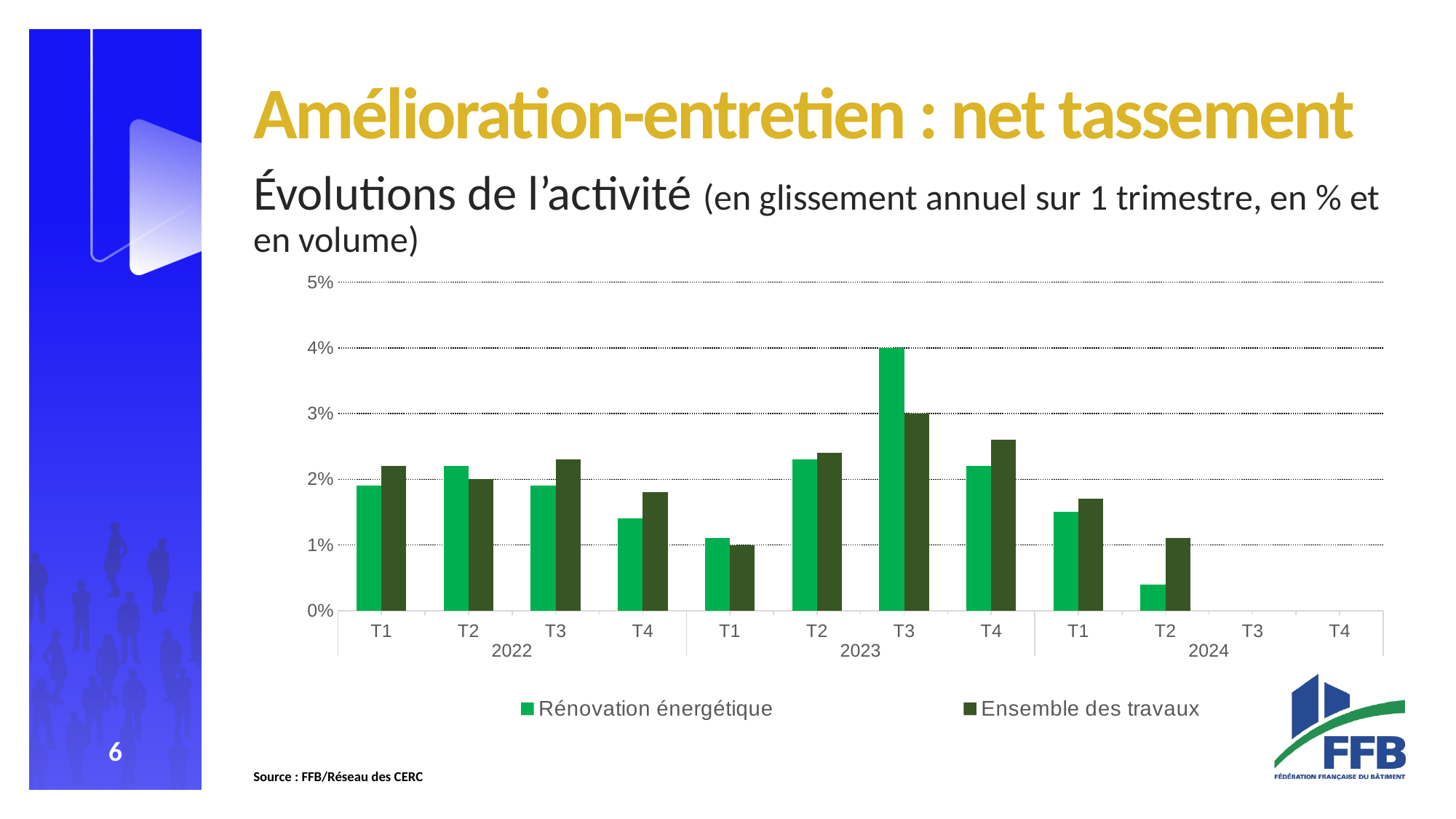
In which quarter is the value for Rénovation énergétique highest? T3 2023 What is the value for Ensemble des travaux in T3 2023? 3% What are the two series named in the legend? Rénovation énergétique and Ensemble des travaux In T1 2022, which series has the larger value, Rénovation énergétique or Ensemble des travaux? Ensemble des travaux What is the value for Rénovation énergétique in T3 2023? 4% In which quarter is the value for Ensemble des travaux highest? T3 2023 Do the values for Rénovation énergétique rise or fall from T3 2023 to T2 2024? fall In T2 2022, which series has the larger value, Rénovation énergétique or Ensemble des travaux? Rénovation énergétique Is the value for Rénovation énergétique in T2 2024 greater or less than 1%? less Among the quarters with bars plotted, in which quarter is the value for Rénovation énergétique lowest? T2 2024 What kind of chart is shown on the slide? Bar chart How many series does the legend list? 2